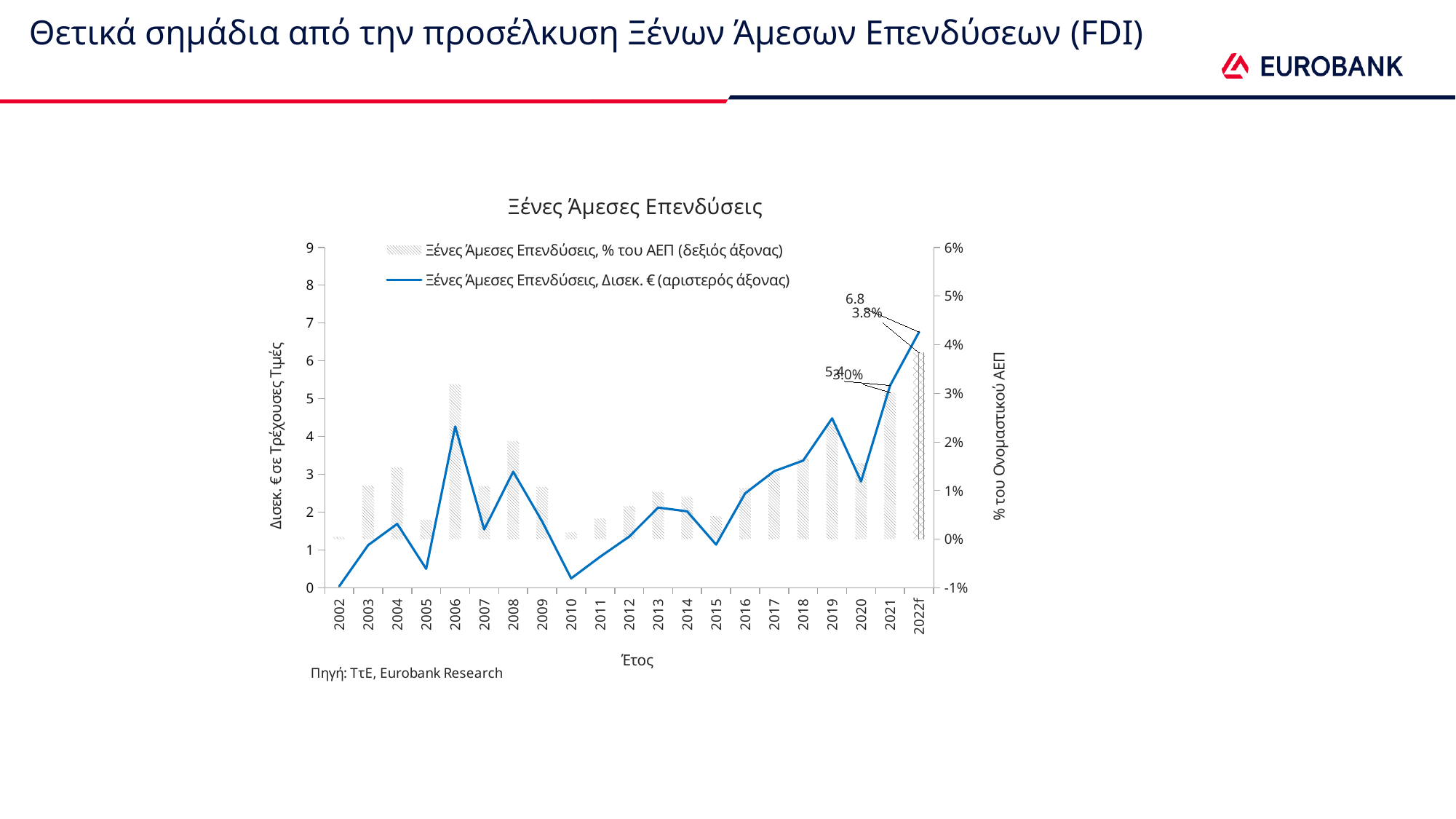
What is the labelled value of FDI as % of GDP for 2022f? 3.8% What kind of chart is shown on the slide? A combined line and bar chart Is the line value (Δισεκ. €) for 2019 greater or less than 4? greater How many series does the legend of the chart list? 2 Is the line value (Δισεκ. €) for 2010 greater or less than 1? less Which year has the larger line value (Δισεκ. €), 2006 or 2008? 2006 In which year does the line series (Δισεκ. €) reach its highest value? 2022f In which year is the line series (Δισεκ. €) at its lowest value? 2002 What is the labelled value of FDI as % of GDP for 2021? 3.0% How many years are shown on the x axis of the chart? 21 Does the line series (Δισεκ. €) rise or fall from 2015 to 2022f? Rise What is the labelled value of the line series (Δισεκ. €) for 2022f? 6.8